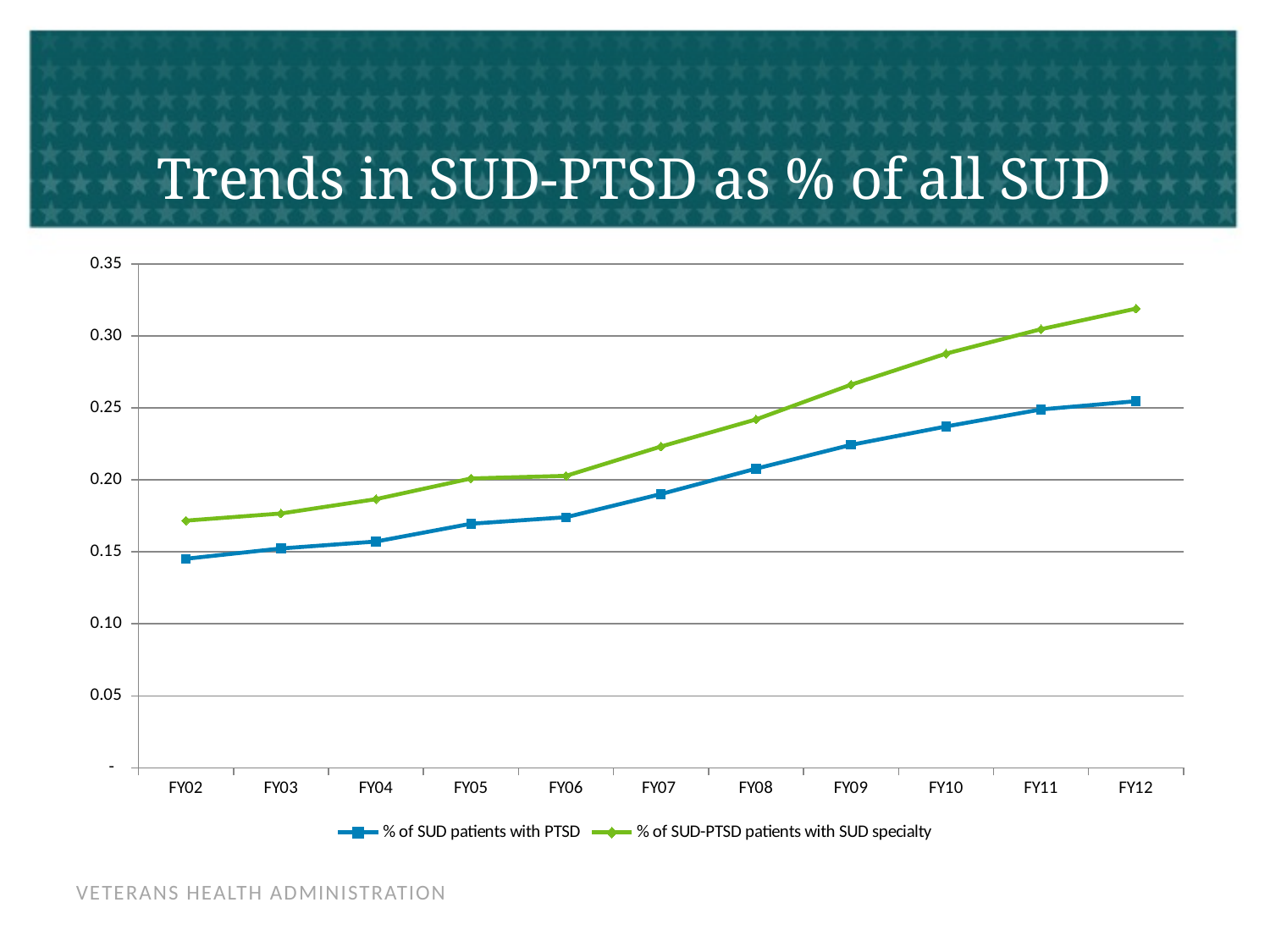
In which fiscal year is '% of SUD-PTSD patients with SUD specialty' lowest? FY02 Is the value for '% of SUD patients with PTSD' in FY06 greater or less than 0.20? less How many series does the legend list? 2 Is the value for '% of SUD-PTSD patients with SUD specialty' in FY12 greater or less than 0.30? greater Is the value for '% of SUD patients with PTSD' in FY02 greater or less than 0.15? less In FY12, which series has the larger value: '% of SUD patients with PTSD' or '% of SUD-PTSD patients with SUD specialty'? % of SUD-PTSD patients with SUD specialty What kind of chart is shown on the slide? line chart Do the values for '% of SUD-PTSD patients with SUD specialty' rise or fall from FY02 to FY12? rise How many fiscal years are plotted along the x axis? 11 What is the title of the chart on the slide? Trends in SUD-PTSD as % of all SUD In which fiscal year is '% of SUD patients with PTSD' highest? FY12